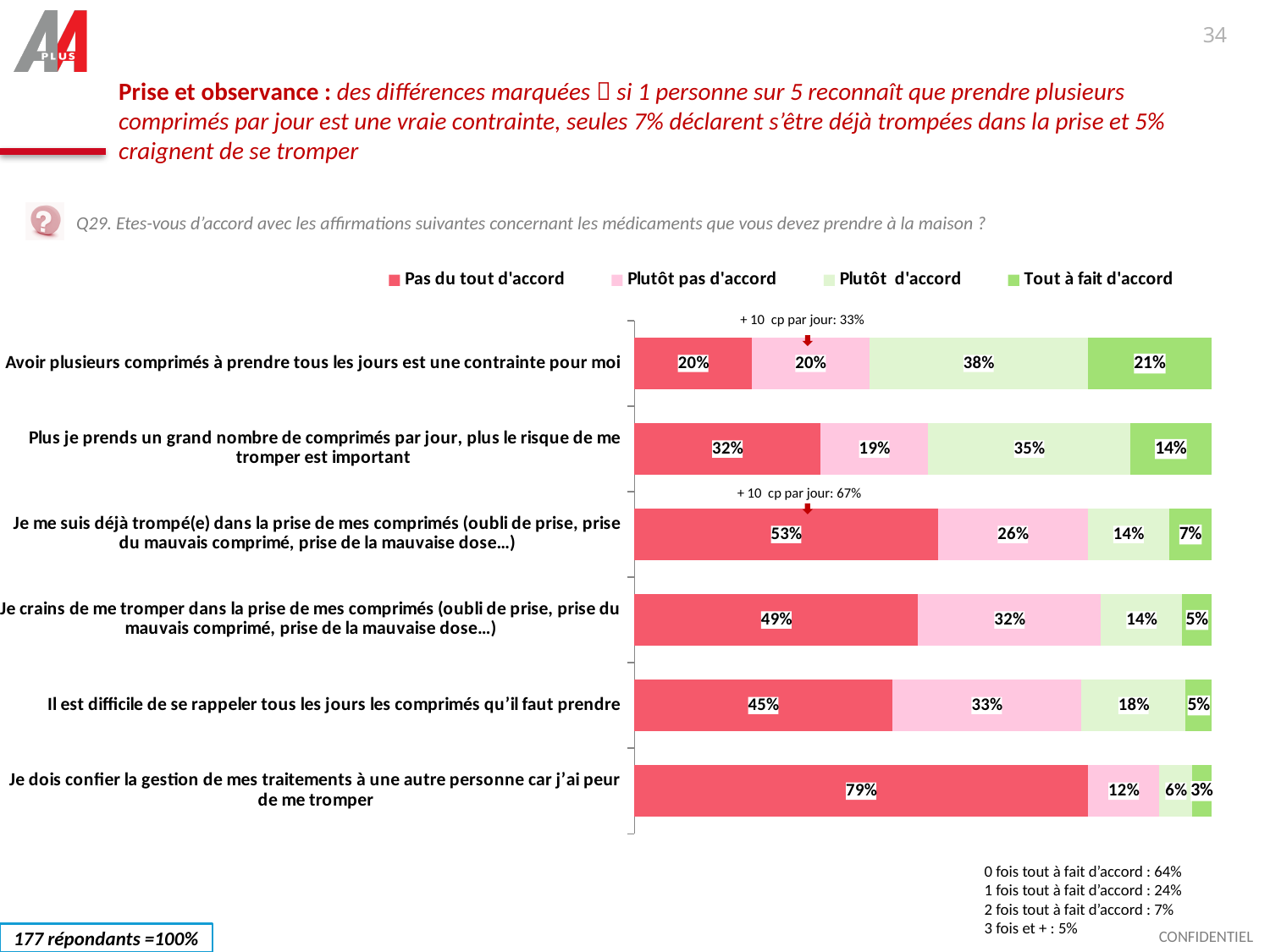
What colour represents 'Tout à fait d'accord' in the legend? Green What is the 'Tout à fait d'accord' value for 'Avoir plusieurs comprimés à prendre tous les jours est une contrainte pour moi'? 21% How many series does the legend list? 4 How many statements (categories) are plotted in the chart? 6 What is the difference between the 'Pas du tout d'accord' values for 'Je me suis déjà trompé(e) dans la prise de mes comprimés' and 'Je crains de me tromper dans la prise de mes comprimés'? 4% What is the 'Plutôt pas d'accord' value for 'Il est difficile de se rappeler tous les jours les comprimés qu'il faut prendre'? 33% Which statement has the lowest 'Tout à fait d'accord' value? Je dois confier la gestion de mes traitements à une autre personne car j'ai peur de me tromper What is the 'Pas du tout d'accord' value for 'Je dois confier la gestion de mes traitements à une autre personne car j'ai peur de me tromper'? 79% What kind of chart is shown on the slide? Stacked bar chart What is the combined 'Plutôt d'accord' and 'Tout à fait d'accord' share for 'Je me suis déjà trompé(e) dans la prise de mes comprimés'? 21% Which is larger: the 'Plutôt d'accord' value for 'Avoir plusieurs comprimés à prendre tous les jours est une contrainte pour moi' or for 'Plus je prends un grand nombre de comprimés par jour, plus le risque de me tromper est important'? Avoir plusieurs comprimés à prendre tous les jours est une contrainte pour moi Which statement has the highest 'Pas du tout d'accord' value? Je dois confier la gestion de mes traitements à une autre personne car j'ai peur de me tromper